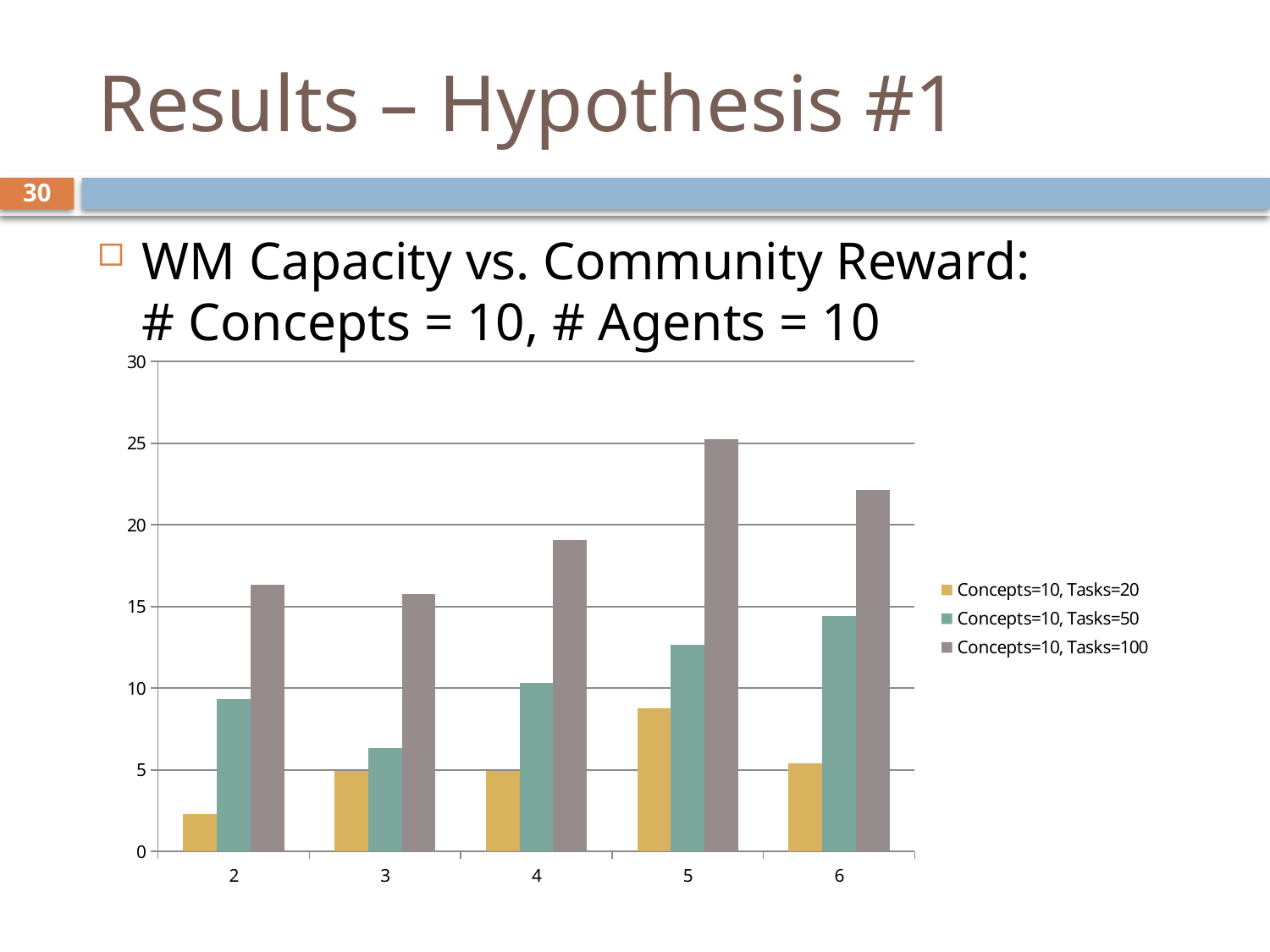
Does the Concepts=10, Tasks=50 series rise or fall from x = 3 to x = 6? rise Is the Concepts=10, Tasks=20 value at x = 2 greater or less than 5? less Which series is shown in the gold/yellow colour? Concepts=10, Tasks=20 How many series does the legend list? 3 How many categories are shown along the x axis? 5 At x = 3, which series has the larger value: Concepts=10, Tasks=50 or Concepts=10, Tasks=100? Concepts=10, Tasks=100 What kind of chart is shown on the slide? bar chart For which x-axis category is the Concepts=10, Tasks=100 bar the highest? 5 For which x-axis category is the Concepts=10, Tasks=50 bar the highest? 6 For which x-axis category is the Concepts=10, Tasks=20 bar the lowest? 2